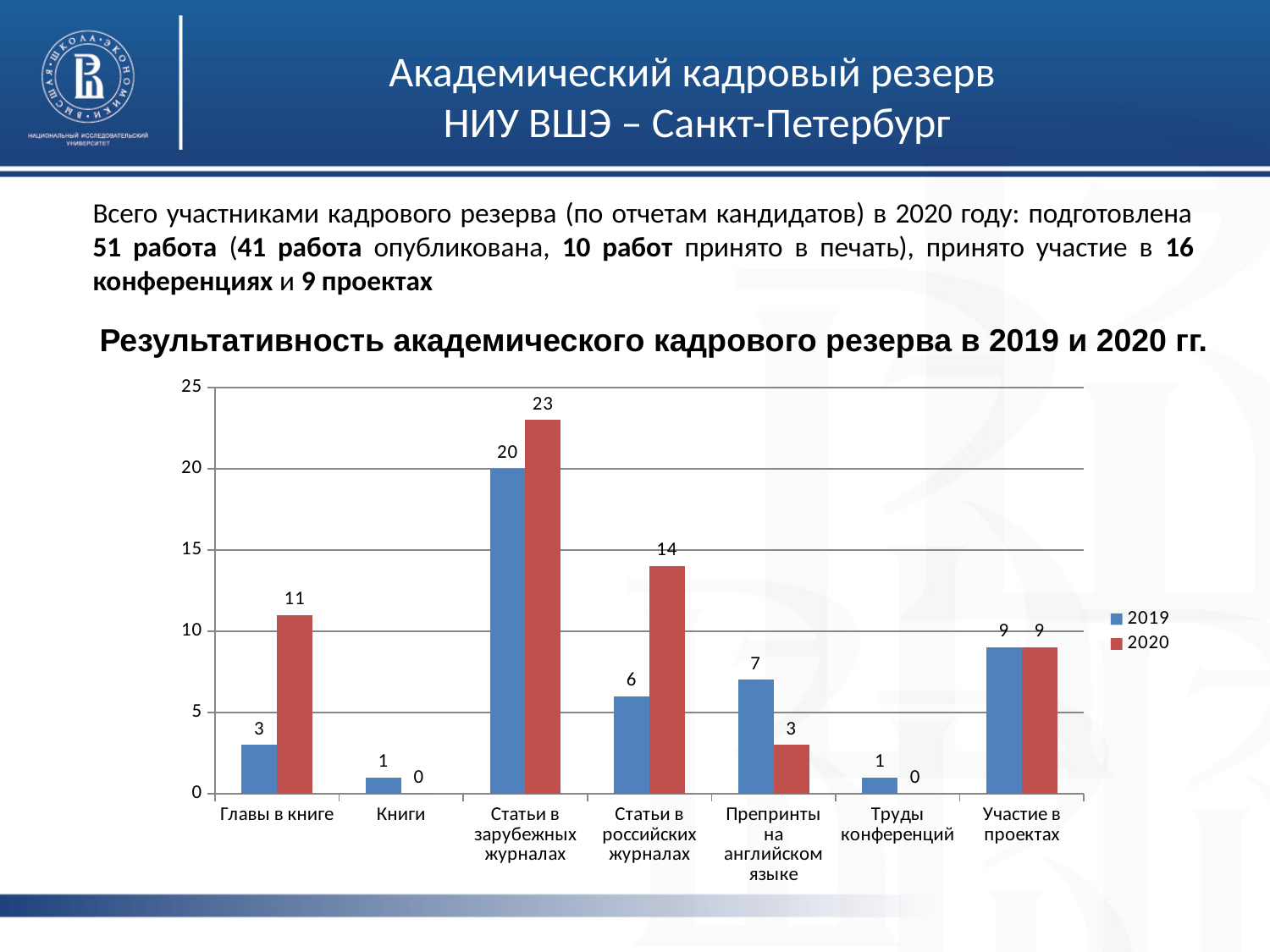
What is the difference between the 2020 and 2019 values for Статьи в российских журналах? 8 Which is larger for Препринты на английском языке: the 2019 value or the 2020 value? 2019 What is the 2020 value for Главы в книге? 11 What is the 2020 value for Препринты на английском языке? 3 What is the 2019 value for Статьи в зарубежных журналах? 20 How many categories are shown on the x axis? 7 What kind of chart is shown on the slide? Bar chart Which category has the lowest 2019 value? Книги and Труды конференций (both 1) How many series does the legend list? 2 Which category has the highest 2020 value? Статьи в зарубежных журналах What is the 2020 value for Труды конференций? 0 What is the title of the chart? Результативность академического кадрового резерва в 2019 и 2020 гг.